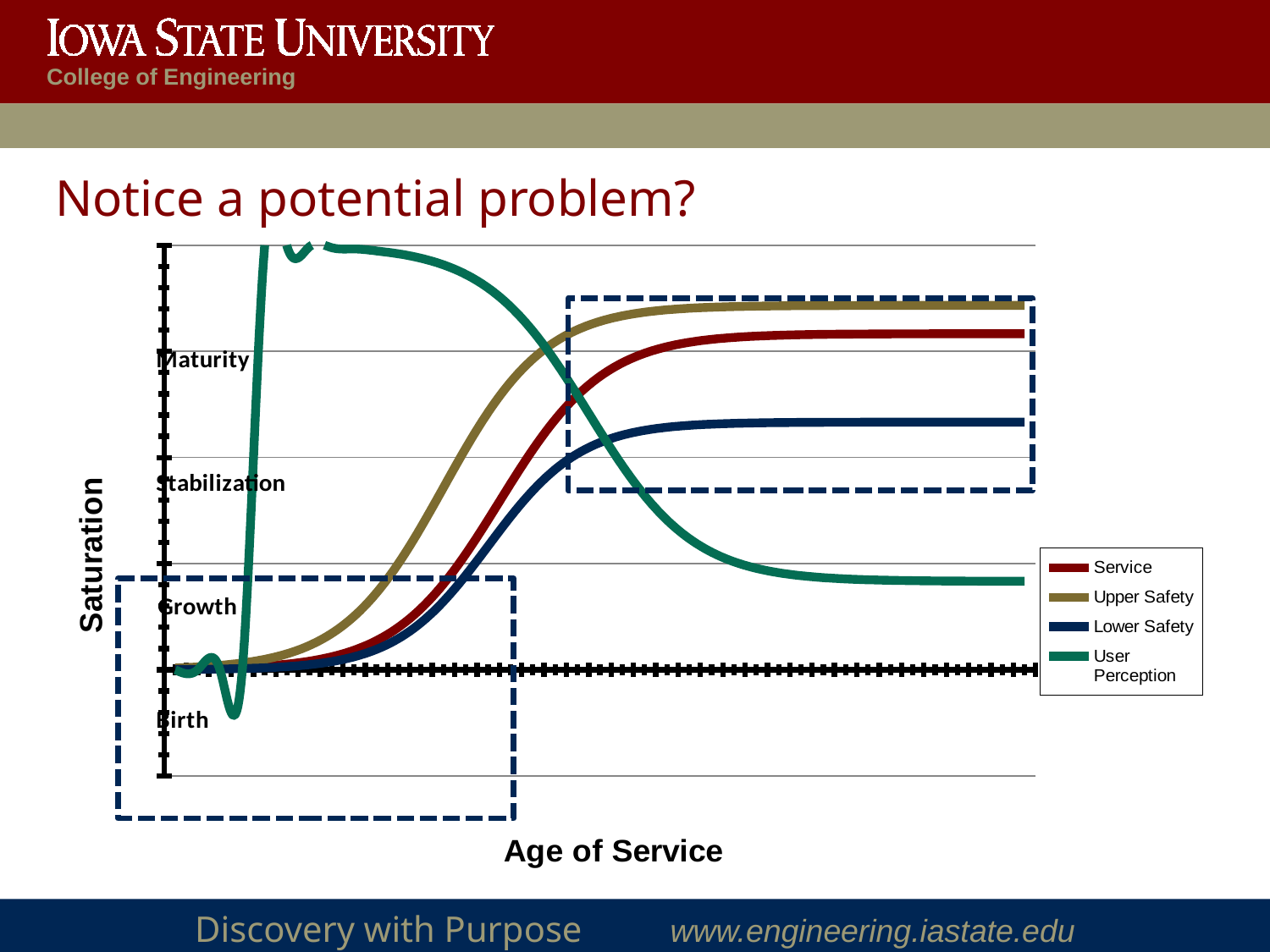
Does the Service series rise or fall as Age of Service increases through the middle of the chart? Rise Does the User Perception series rise or fall across the right half of the chart? Fall Which series plateaus at the highest level at the right end of the chart? Upper Safety How many series does the legend list? 4 What kind of chart is shown on the slide? Line chart Which series plateaus at the lowest level at the right end of the chart? User Perception Which series is drawn in green? User Perception At the right end of the chart, which series is higher: Upper Safety or Service? Upper Safety What is the title of the vertical axis? Saturation At the right end of the chart, which series is higher: Service or Lower Safety? Service What is the title of the horizontal axis? Age of Service